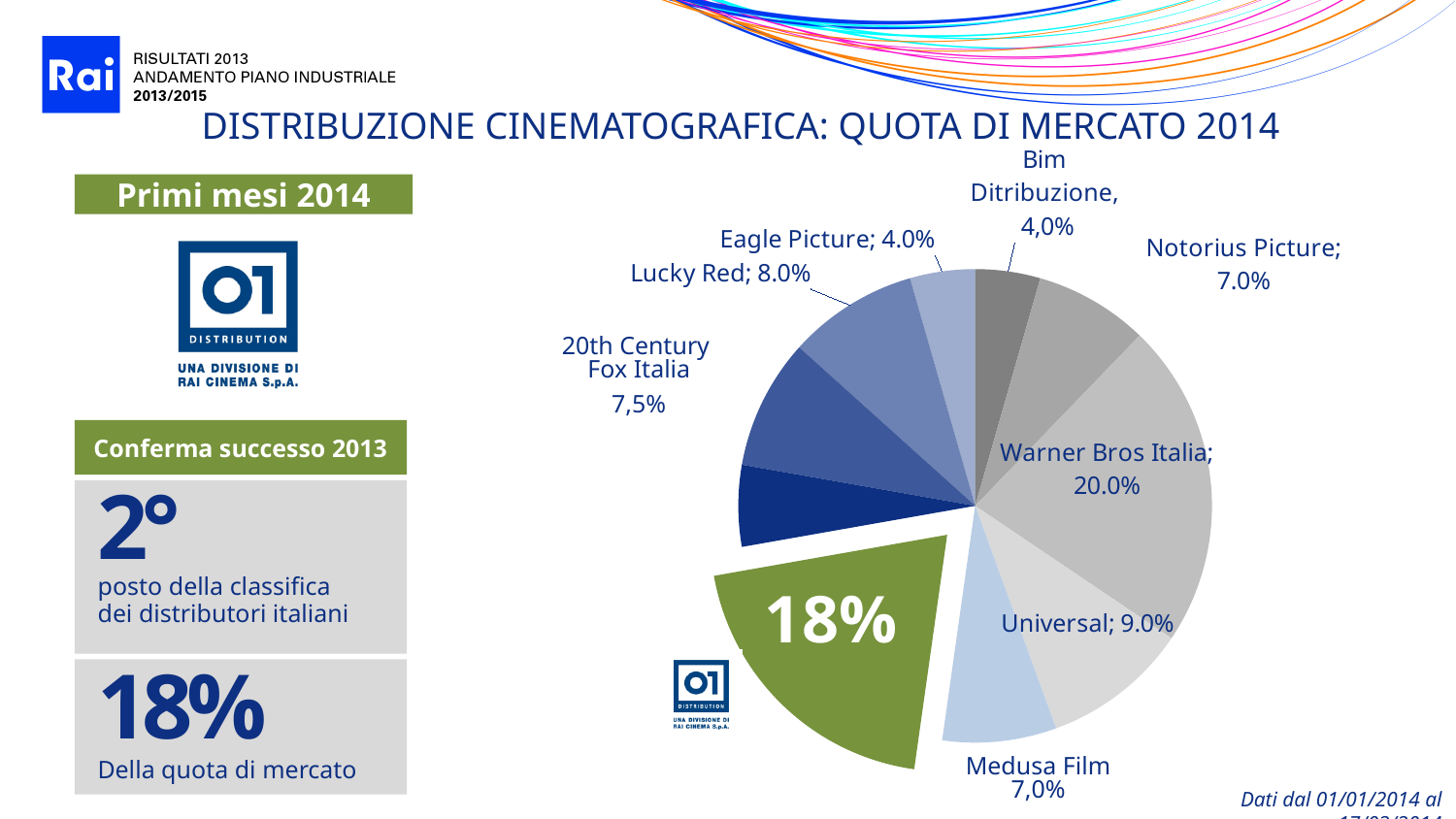
What type of chart is shown on the slide? pie chart What market share is shown for Lucky Red? 8.0% What is the difference in market share between Warner Bros Italia and Universal? 11.0 percentage points What market share is shown for Universal? 9.0% What is the difference in market share between Lucky Red and Eagle Picture? 4.0 percentage points What market share is shown for 01 Distribution (the green slice)? 18% What market share is shown for 20th Century Fox Italia? 7,5% What market share is shown for Medusa Film? 7,0% Which distributor has the largest market share in the pie chart? Warner Bros Italia What market share is shown for Warner Bros Italia? 20.0% What is the title of the chart on the slide? DISTRIBUZIONE CINEMATOGRAFICA: QUOTA DI MERCATO 2014 Which has a larger market share, Notorius Picture or Universal? Universal